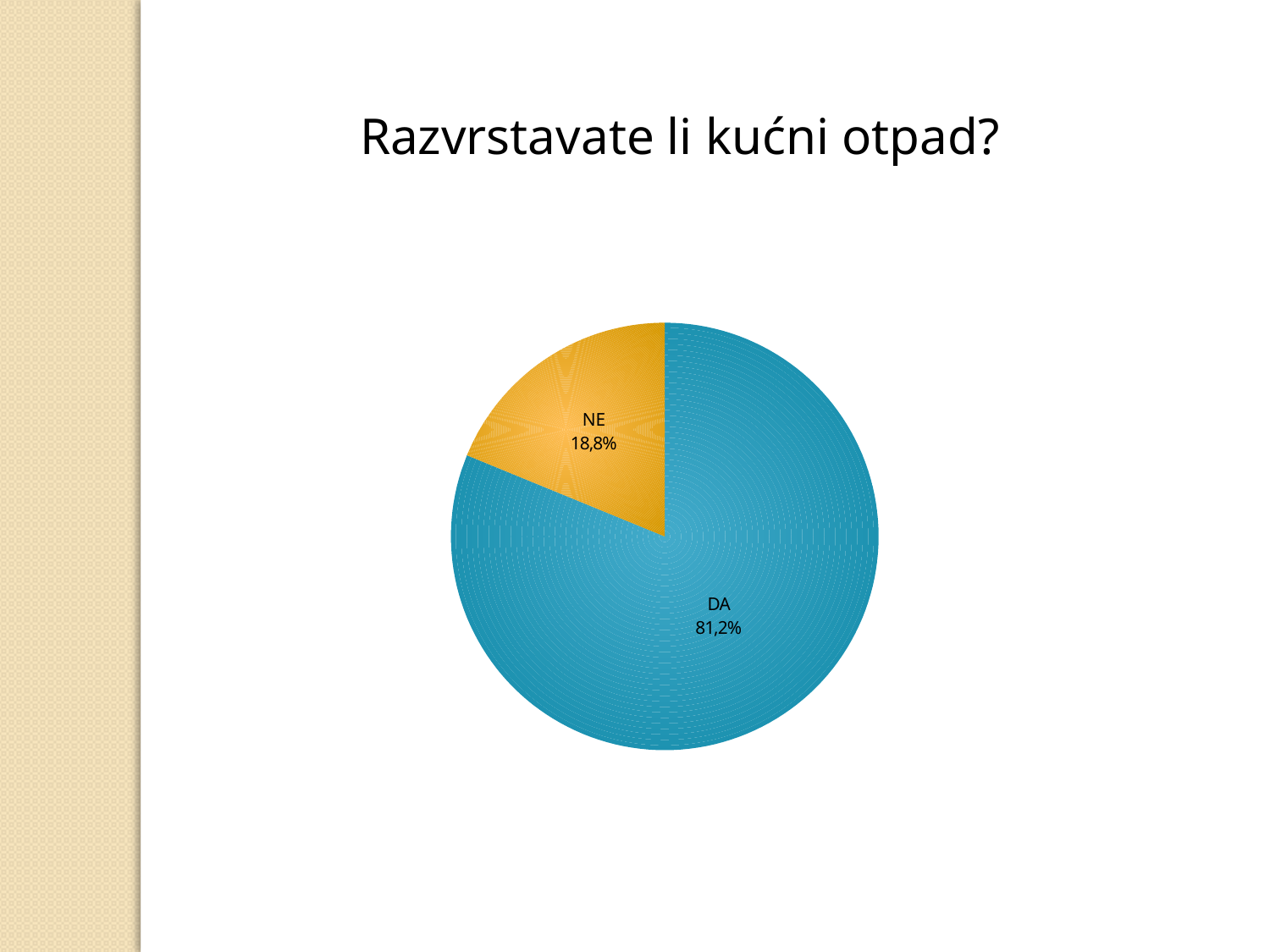
What is the value for NE? 18,8% Which category has the largest slice? DA What share of the pie does the NE slice represent? 18,8% Which category has the smallest slice? NE What kind of chart is shown on the slide? pie chart What is the title of the slide above the chart? Razvrstavate li kućni otpad? How many slices does the pie chart have? 2 What is the difference between the DA and NE values? 62,4% What is the value for DA? 81,2% Which is larger, DA or NE? DA What colour is the DA slice? blue